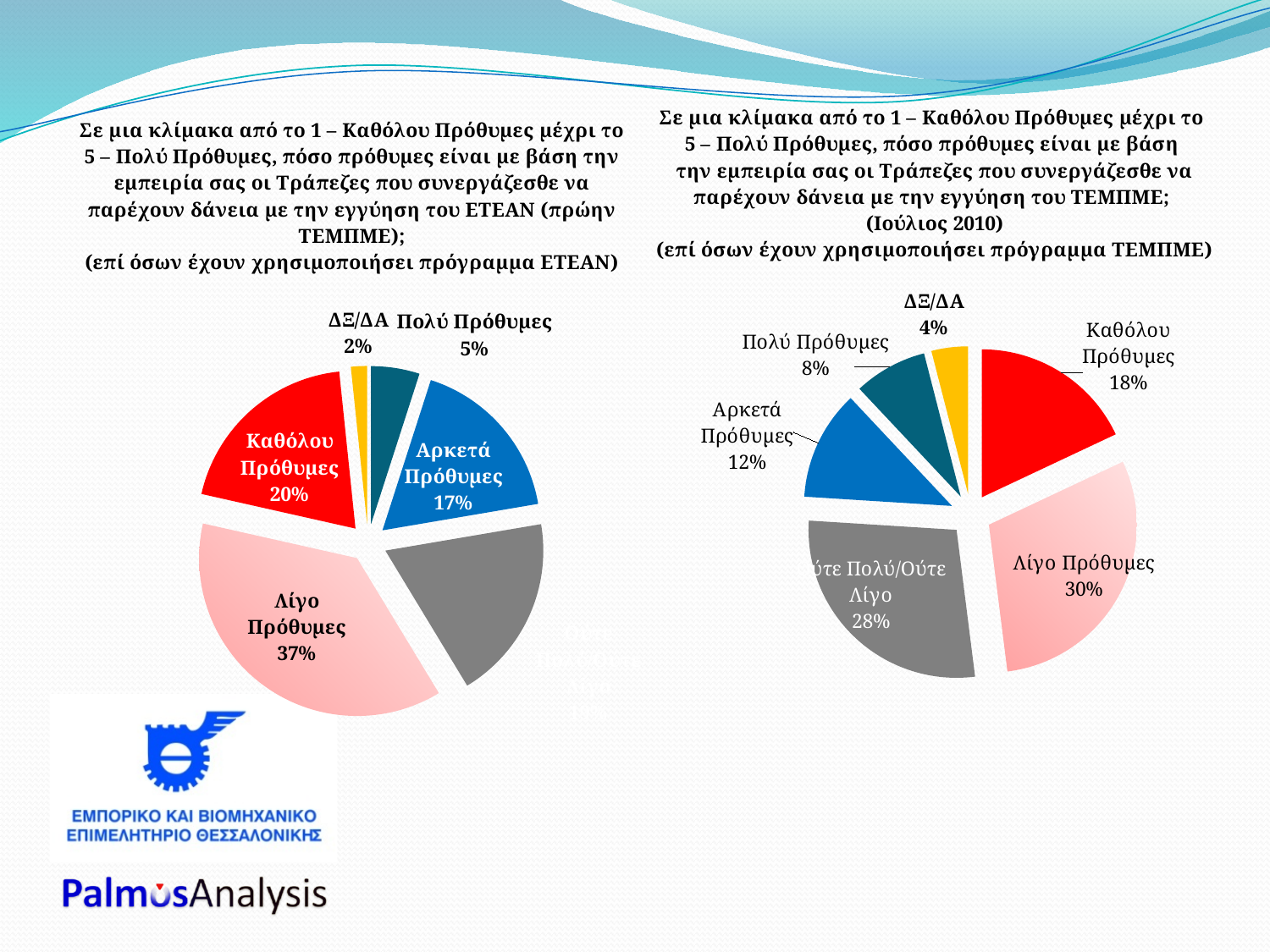
What type of chart is used on the right side of the slide? Pie chart In the right pie chart (ΤΕΜΠΜΕ, Ιούλιος 2010), which is larger: Καθόλου Πρόθυμες or Αρκετά Πρόθυμες? Καθόλου Πρόθυμες In the left pie chart (ETEAN), what share is labelled for Καθόλου Πρόθυμες? 20% In the right pie chart (ΤΕΜΠΜΕ, Ιούλιος 2010), what share is labelled for Πολύ Πρόθυμες? 8% In the right pie chart (ΤΕΜΠΜΕ, Ιούλιος 2010), what share is labelled for Λίγο Πρόθυμες? 30% In the left pie chart (ETEAN), which labelled category has the largest share? Λίγο Πρόθυμες In the left pie chart (ETEAN), what share is labelled for Αρκετά Πρόθυμες? 17% In the right pie chart (ΤΕΜΠΜΕ, Ιούλιος 2010), which category has the smallest share? ΔΞ/ΔΑ In the right pie chart (ΤΕΜΠΜΕ, Ιούλιος 2010), what share is labelled for Ούτε Πολύ/Ούτε Λίγο? 28% In the left pie chart (ETEAN), what share is labelled for ΔΞ/ΔΑ? 2% In the left pie chart (ETEAN), what is the difference between the shares of Καθόλου Πρόθυμες and Πολύ Πρόθυμες? 15% In the left pie chart (ETEAN), what share is labelled for Λίγο Πρόθυμες? 37%